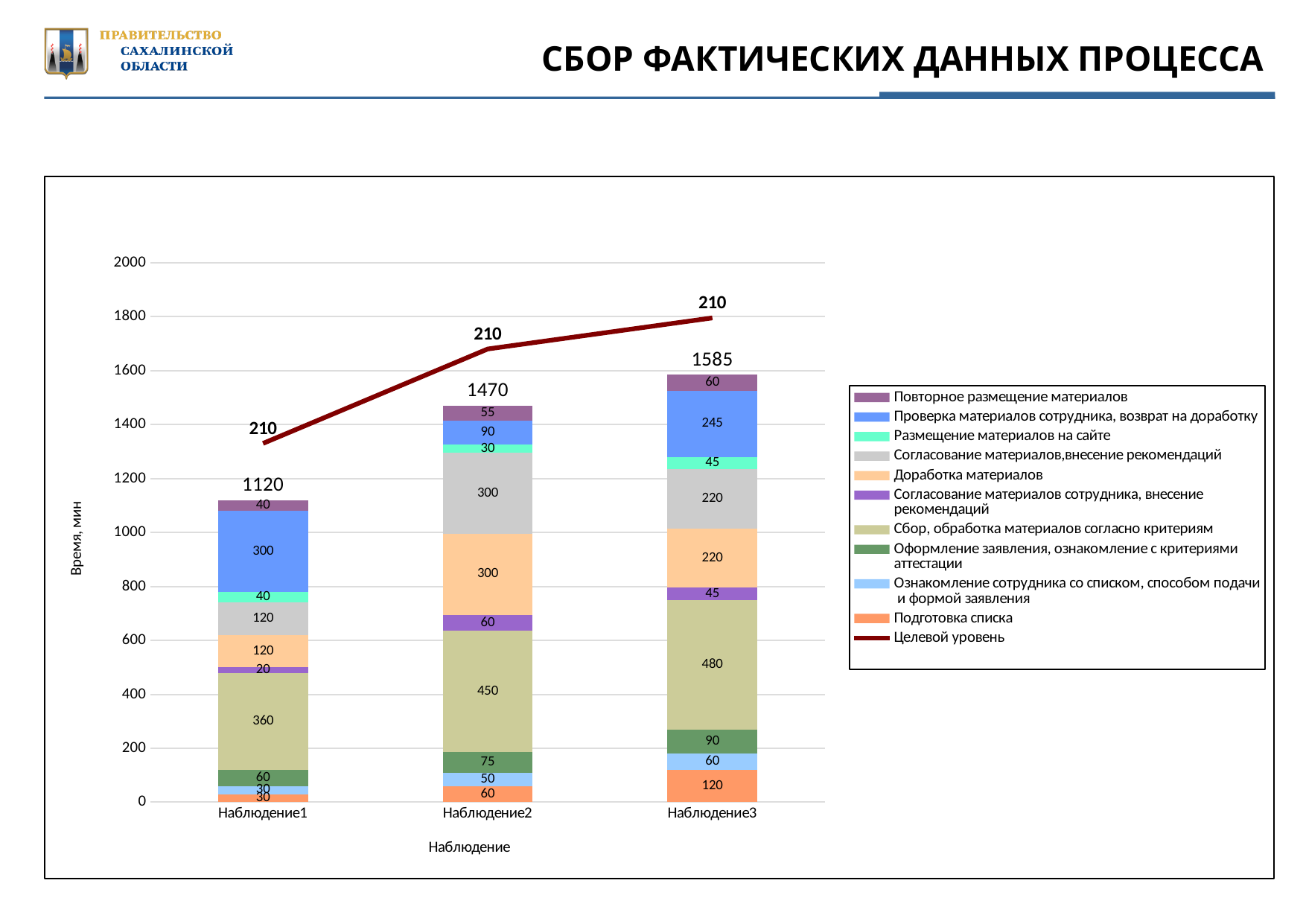
How many series does the legend list? 11 How many observations (categories) are shown on the x axis? 3 What type of chart is shown on the slide? Stacked bar chart with a line What is the value of 'Проверка материалов сотрудника, возврат на доработку' for Наблюдение1? 300 Which is larger: 'Подготовка списка' for Наблюдение3 or for Наблюдение1? Наблюдение3 What is the label of the y axis? Время, мин What is the value of 'Сбор, обработка материалов согласно критериям' for Наблюдение3? 480 Which observation has the highest total time? Наблюдение3 What is the total value of the stacked bar for Наблюдение2? 1470 What is the difference between the total for Наблюдение3 and the total for Наблюдение1? 465 Which observation has the lowest total time? Наблюдение1 What is the value of 'Доработка материалов' for Наблюдение2? 300